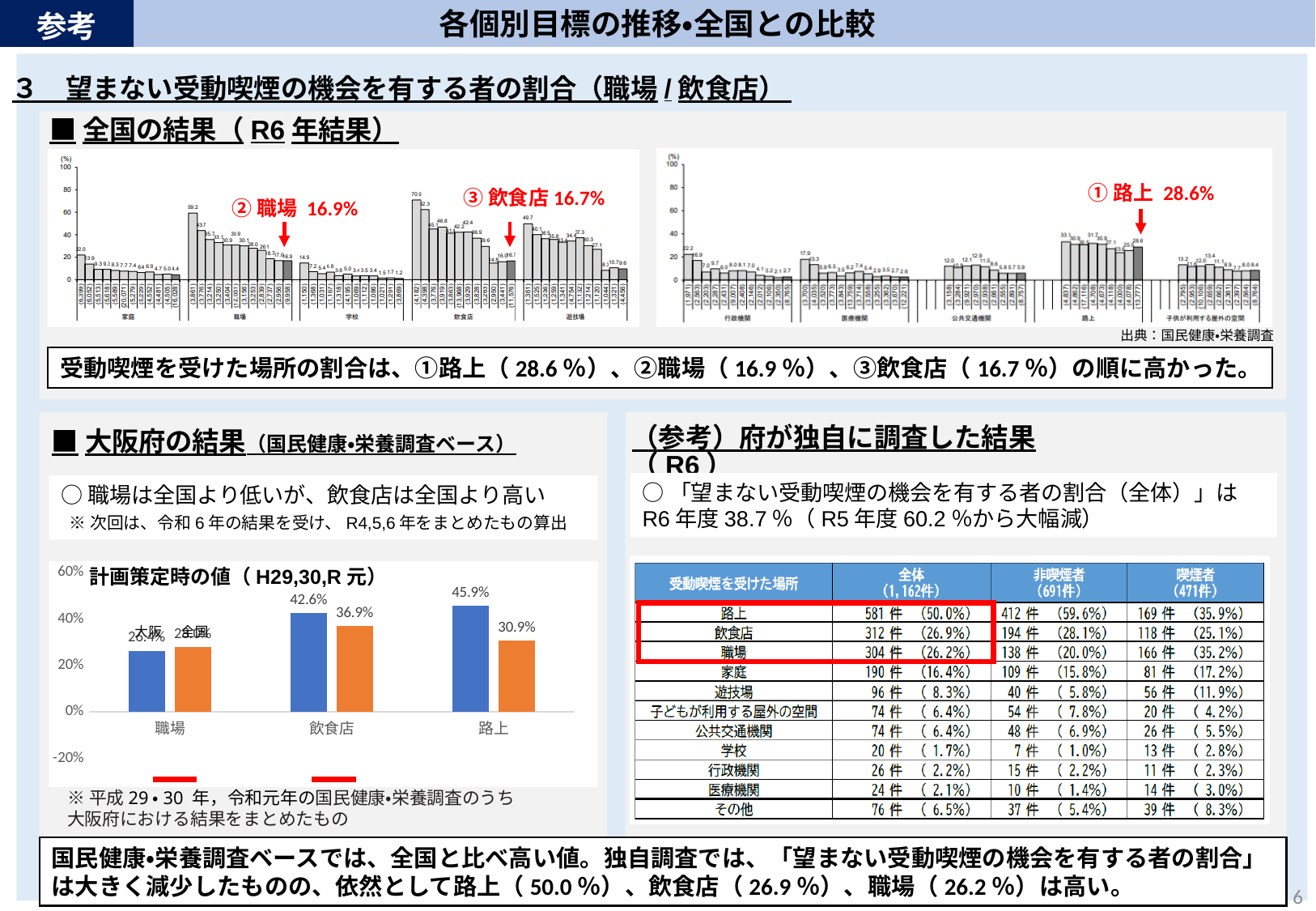
In the bottom-left chart titled 計画策定時の値（H29,30,R元）, what is the value for 全国 in the 飲食店 category? 36.9% What kind of chart is the bottom-left chart titled 計画策定時の値（H29,30,R元）? bar chart In the bottom-left chart titled 計画策定時の値（H29,30,R元）, how many categories are shown on the x axis? 3 In the bottom-left chart titled 計画策定時の値（H29,30,R元）, what is the value for 大阪 in the 飲食店 category? 42.6% In the top-left national results chart, what value is annotated for 職場? 16.9% In the top-right national results chart, what value is annotated for 路上? 28.6% In the bottom-left chart titled 計画策定時の値（H29,30,R元）, what is the value for 大阪 in the 路上 category? 45.9% In the bottom-left chart titled 計画策定時の値（H29,30,R元）, what is the difference between the 大阪 and 全国 values for 路上? 15.0% In the bottom-left chart titled 計画策定時の値（H29,30,R元）, which category has the highest 大阪 value? 路上 In the bottom-left chart titled 計画策定時の値（H29,30,R元）, which is larger for 飲食店, the 大阪 value or the 全国 value? 大阪 In the bottom-left chart titled 計画策定時の値（H29,30,R元）, what is the value for 全国 in the 路上 category? 30.9% In the bottom-left chart titled 計画策定時の値（H29,30,R元）, how many series does the legend list? 2